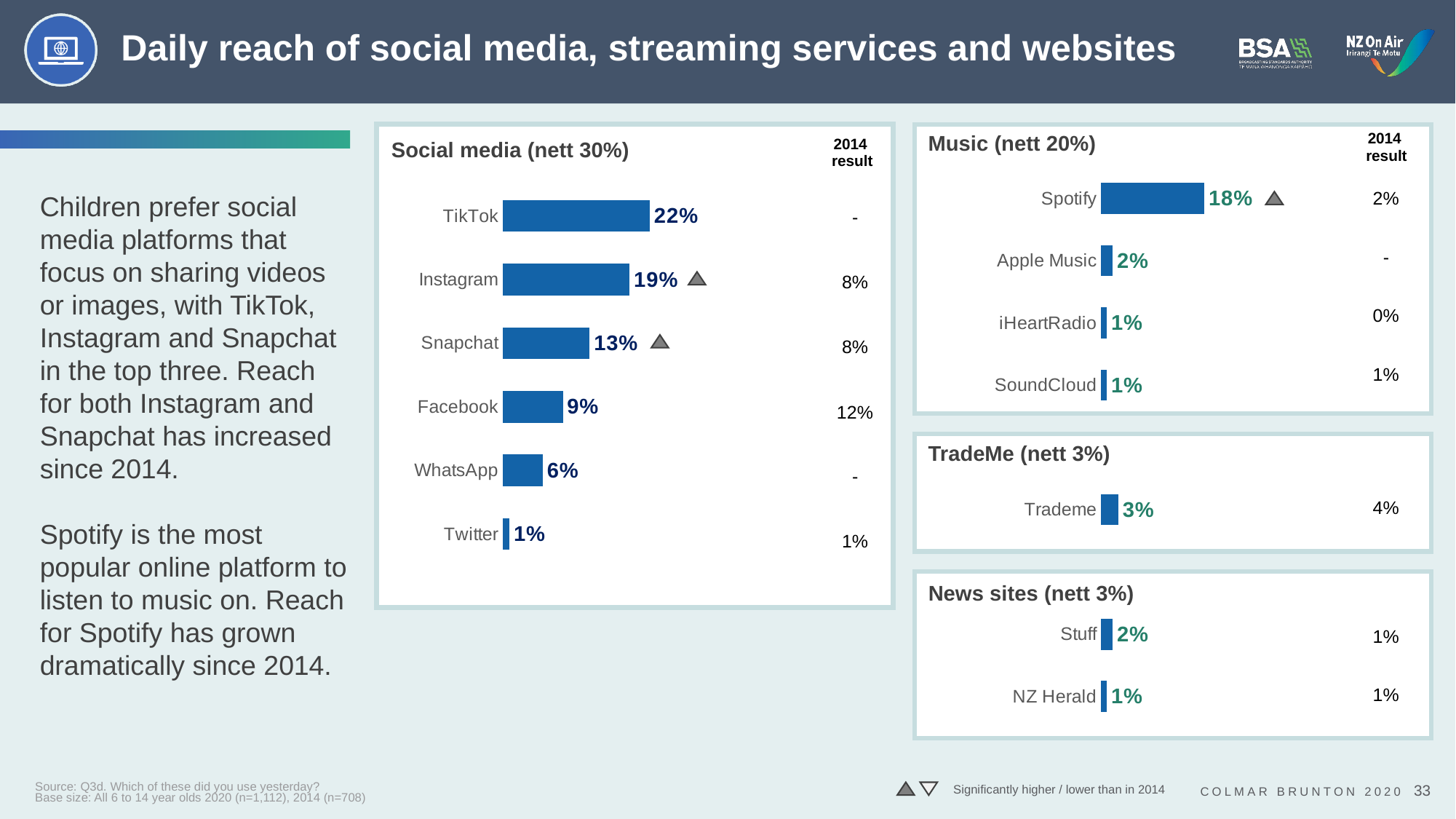
In the Social media chart, which platform has the highest daily reach? TikTok In the Social media chart, what is the daily reach value for TikTok? 22% In the Social media chart, how many platforms are plotted? 6 What type of chart is used in the Social media panel? Bar chart In the Music chart, what is the difference between the 2020 value for Spotify and its 2014 result? 16% In the Music chart, which is larger, the value for Apple Music or the value for iHeartRadio? Apple Music In the TradeMe chart, what is the daily reach value for Trademe? 3% In the News sites chart, what is the daily reach value for Stuff? 2% In the Music chart, what is the daily reach value for Spotify? 18% In the Social media chart, what was the 2014 result for Facebook? 12% In the Social media chart, which platform has the lowest daily reach? Twitter In the Social media chart, what is the difference between the values for Instagram and Facebook? 10%